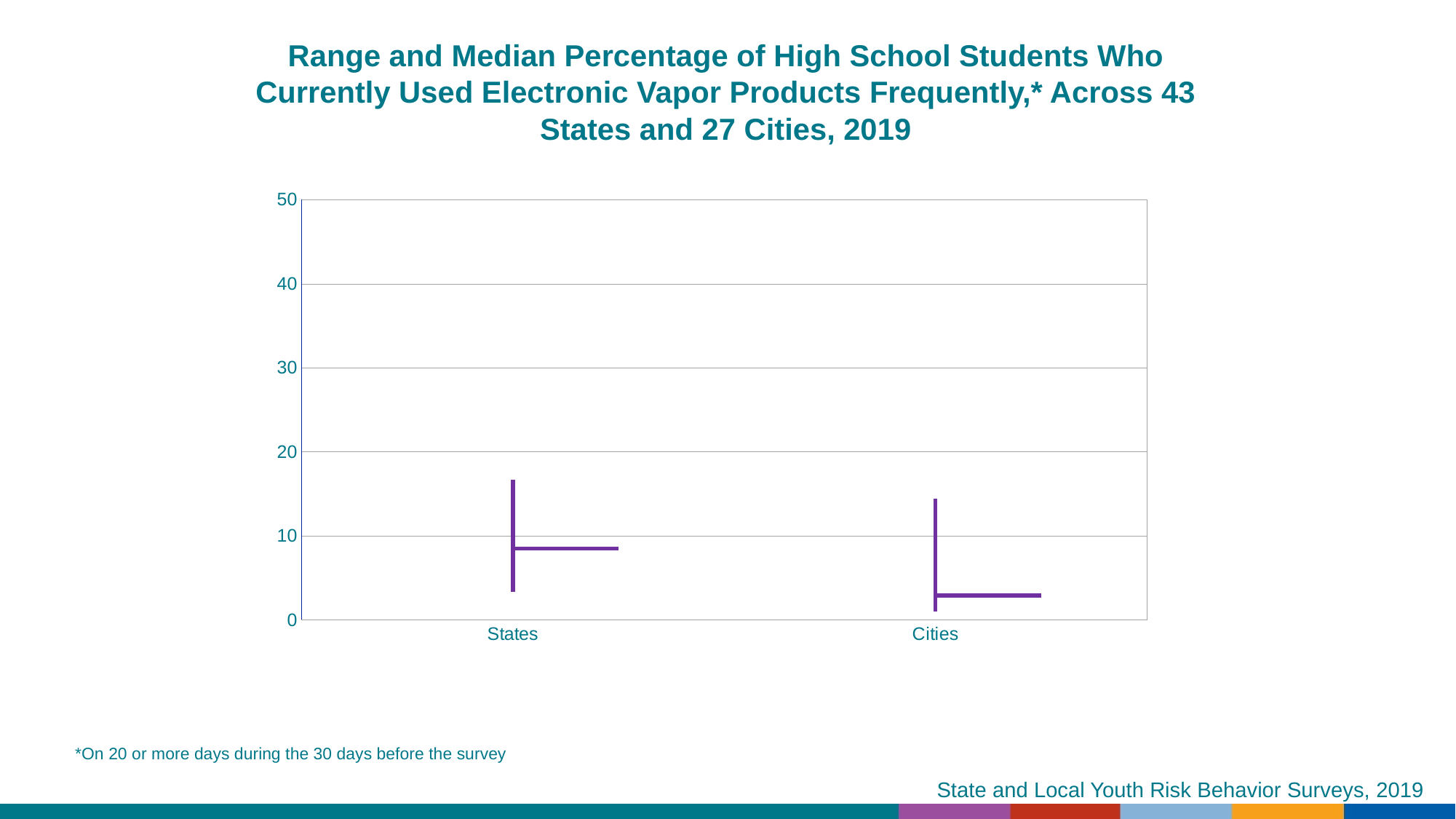
Is the top of the range for Cities greater or less than 10? greater Which category has the higher median, States or Cities? States What is the highest value shown on the y axis? 50 Which category has the higher maximum value in its range? States Is the top of the range for States greater or less than 20? less According to the footnote, what does 'frequently' mean in this chart? On 20 or more days during the 30 days before the survey Is the median value for States greater or less than 10? less How many categories are shown on the x axis? 2 Which category has the lower minimum value in its range? Cities